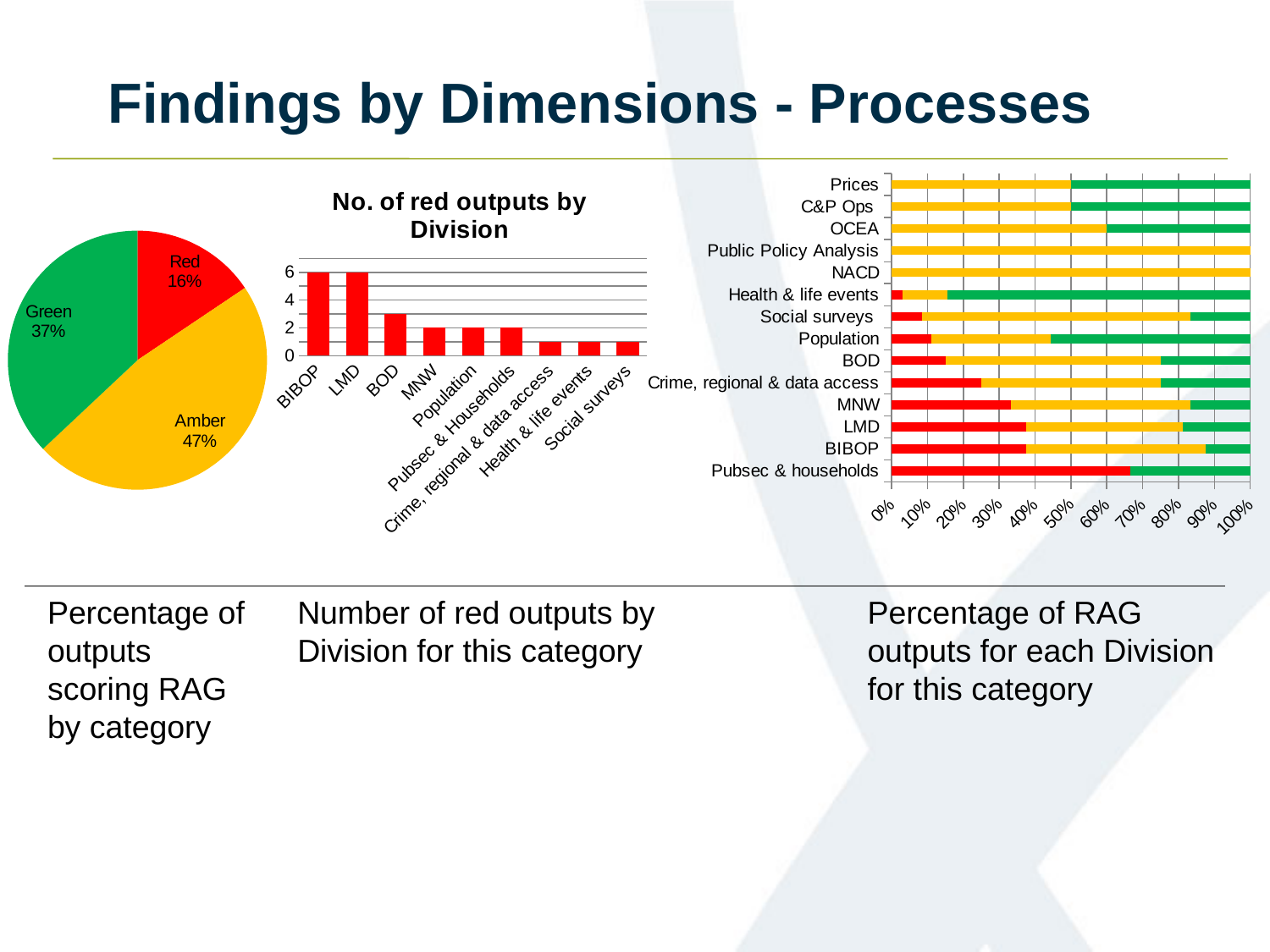
What kind of chart is 'No. of red outputs by Division'? bar chart In the pie chart on the left, what percentage of outputs scored Red? 16% In the pie chart on the left, what percentage of outputs scored Amber? 47% In the chart 'No. of red outputs by Division', how many red outputs does BIBOP have? 6 In the chart 'No. of red outputs by Division', is the value for BOD greater or less than 4? less In the chart 'No. of red outputs by Division', how many divisions are shown on the x axis? 9 In the pie chart on the left, what is the difference in percentage points between the Amber and Green shares? 10 In the chart 'No. of red outputs by Division', which is larger, the value for LMD or the value for Population? LMD In the stacked bar chart on the right, which division has the largest red share? Pubsec & households In the pie chart on the left, which category has the largest share? Amber In the chart 'No. of red outputs by Division', how many red outputs does MNW have? 2 In the pie chart on the left, which category has the smallest share? Red